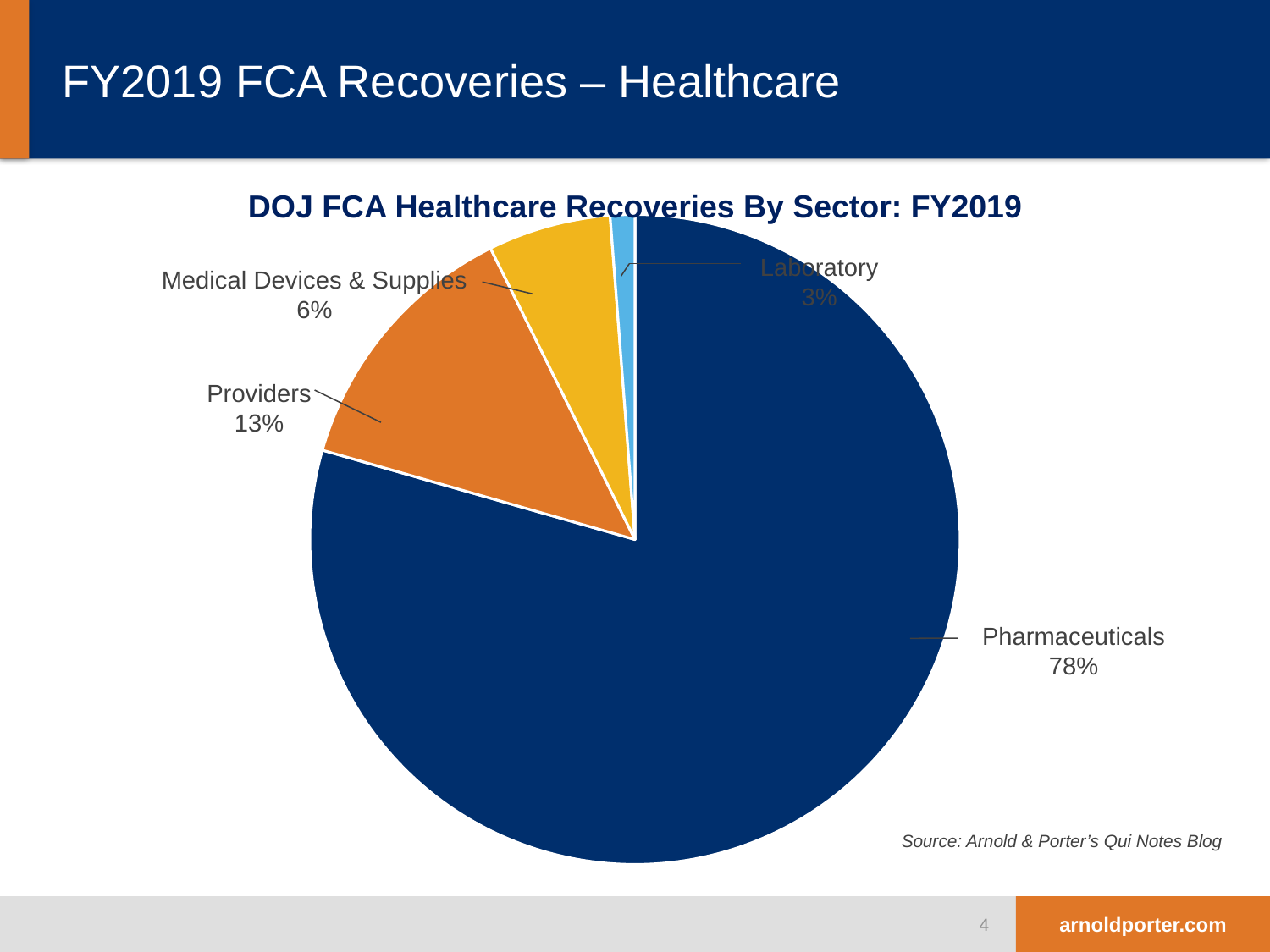
What colour is the Pharmaceuticals slice? Dark blue What percentage of recoveries came from Medical Devices & Supplies? 6% What share of FY2019 DOJ FCA healthcare recoveries came from Pharmaceuticals? 78% What is the difference in percentage points between the Pharmaceuticals and Providers shares? 65 percentage points Which sector accounts for the largest share of recoveries? Pharmaceuticals What kind of chart is shown on the slide? Pie chart Which sector accounts for the smallest share of recoveries? Laboratory What share of recoveries is attributed to Providers? 13% What is the title of the chart? DOJ FCA Healthcare Recoveries By Sector: FY2019 Which has a larger share, Providers or Medical Devices & Supplies? Providers How many sectors are shown in the pie chart? 4